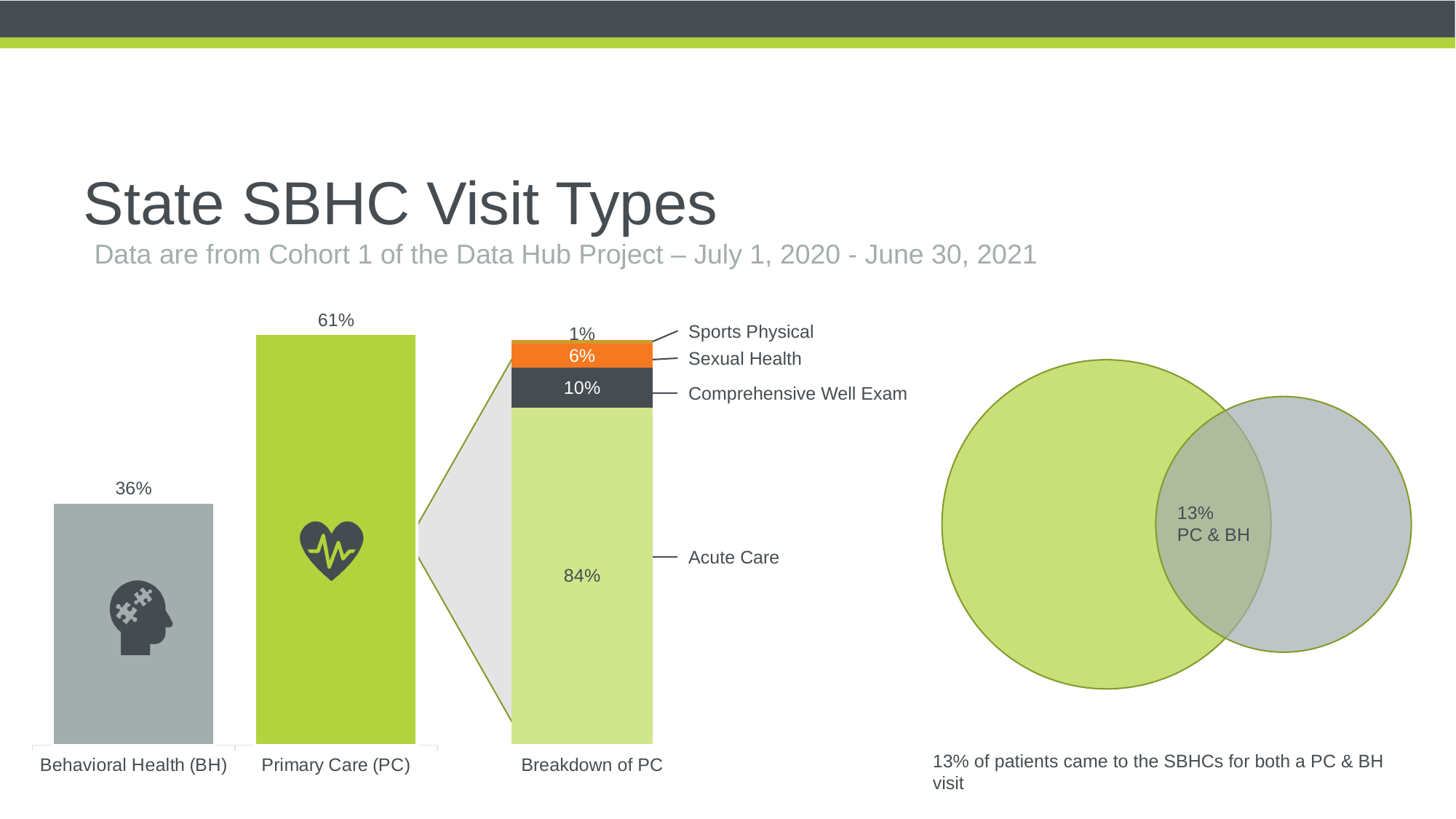
How many segments make up the Breakdown of PC stacked bar? 4 In the Breakdown of PC stacked bar, which segment is the smallest? Sports Physical In the bar chart on the left, what is the value for Behavioral Health (BH)? 36% In the bar chart on the left, what is the difference between the Primary Care (PC) value and the Behavioral Health (BH) value? 25 percentage points In the Venn diagram on the right, what percentage of patients came for both a PC and BH visit? 13% In the Breakdown of PC stacked bar, what is the difference between the Acute Care share and the Comprehensive Well Exam share? 74 percentage points In the bar chart on the left, which category has the higher value, Behavioral Health (BH) or Primary Care (PC)? Primary Care (PC) In the Breakdown of PC stacked bar, what share is Sexual Health? 6% In the Breakdown of PC stacked bar, what share is Comprehensive Well Exam? 10% In the Breakdown of PC stacked bar, which segment is the largest? Acute Care In the Breakdown of PC stacked bar, what share is Acute Care? 84% In the bar chart on the left, what is the value for Primary Care (PC)? 61%